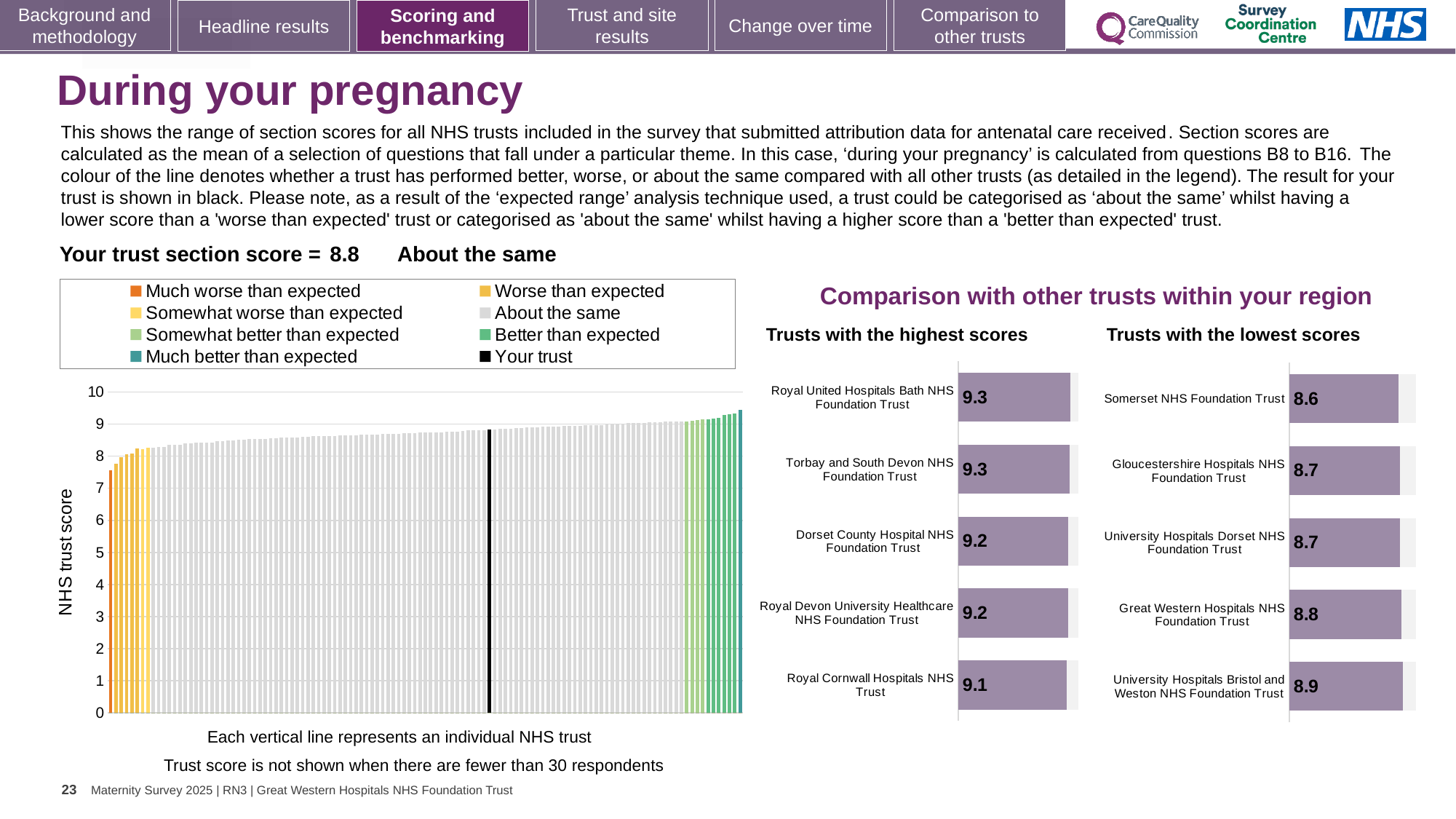
In the 'Trusts with the highest scores' chart, what is the score for Royal Cornwall Hospitals NHS Trust? 9.1 In the 'Trusts with the lowest scores' chart, what is the difference between the scores of University Hospitals Bristol and Weston NHS Foundation Trust and Somerset NHS Foundation Trust? 0.3 How many entries does the legend of the main 'NHS trust score' chart list? 8 In the main 'NHS trust score' chart, do the values rise or fall from left to right? Rise In the 'Trusts with the highest scores' chart, which trust has the lowest score? Royal Cornwall Hospitals NHS Trust In the 'Trusts with the lowest scores' chart, what is the score for Somerset NHS Foundation Trust? 8.6 What kind of chart is the main 'NHS trust score' chart on the left? Bar chart In the 'Trusts with the lowest scores' chart, which trust has the highest score? University Hospitals Bristol and Weston NHS Foundation Trust In the main 'NHS trust score' chart, is the value of the black 'Your trust' bar greater or less than 8? greater In the 'Trusts with the highest scores' chart, what is the difference between the scores of Royal United Hospitals Bath NHS Foundation Trust and Royal Cornwall Hospitals NHS Trust? 0.2 In the 'Trusts with the lowest scores' chart, which has the higher score: Great Western Hospitals NHS Foundation Trust or Gloucestershire Hospitals NHS Foundation Trust? Great Western Hospitals NHS Foundation Trust How many trusts are shown in the 'Trusts with the highest scores' chart? 5